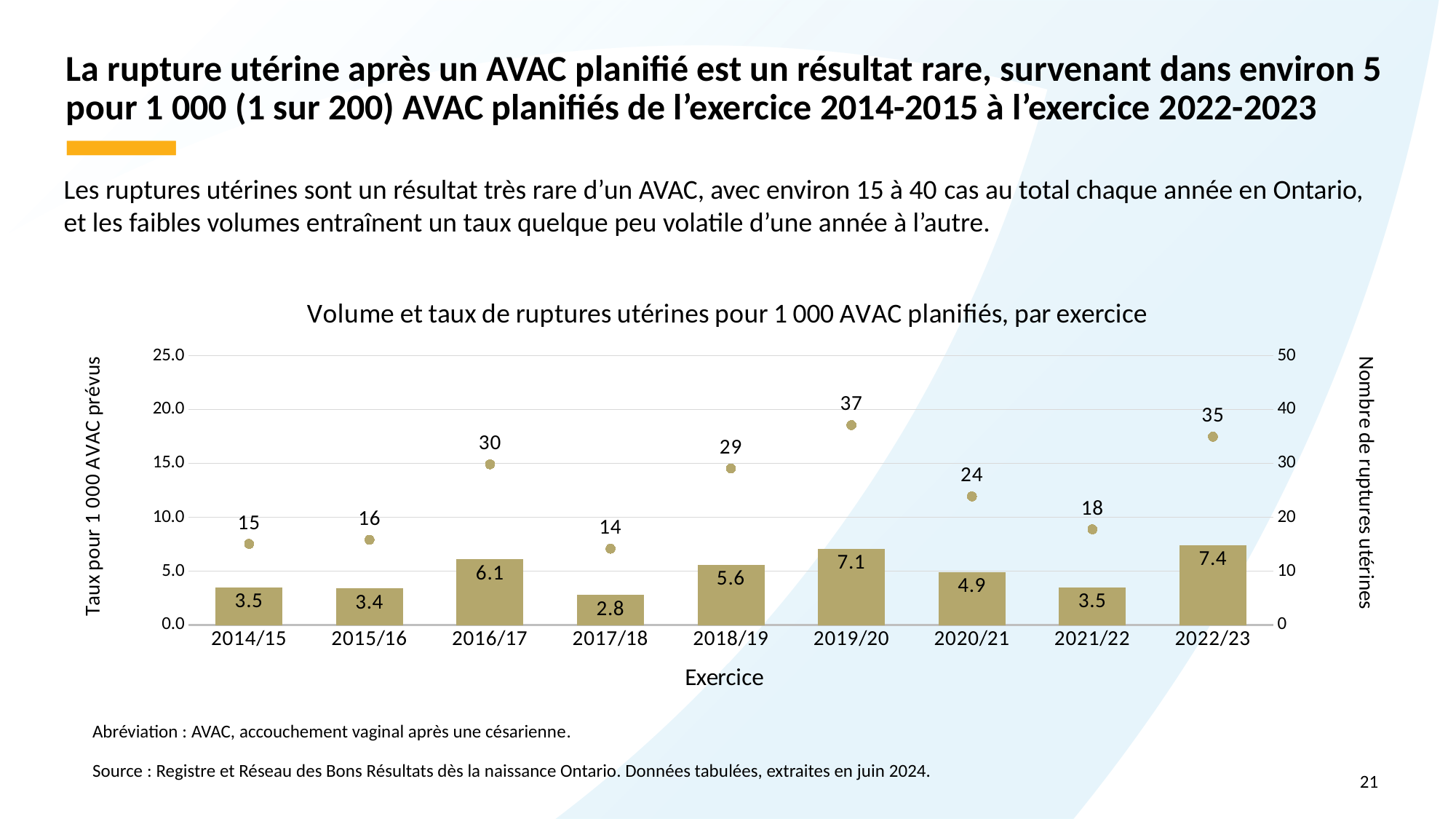
Which fiscal year has the highest rate of uterine ruptures per 1,000 planned VBACs? 2022/23 Which year has a higher number of uterine ruptures, 2016/17 or 2018/19? 2016/17 Which fiscal year has the lowest number of uterine ruptures? 2017/18 What is the title of the chart? Volume et taux de ruptures utérines pour 1 000 AVAC planifiés, par exercice Does the rate per 1,000 planned VBACs rise or fall from 2021/22 to 2022/23? Rise What is the difference in the rate per 1,000 planned VBACs between 2022/23 and 2020/21? 2.5 What kind of chart is used to show the rate per 1,000 planned VBACs? Bar chart What is the rate of uterine ruptures per 1,000 planned VBACs (bar value) for 2016/17? 6.1 What is the number of uterine ruptures (dot value) for 2019/20? 37 How many fiscal years are shown on the x axis of the chart? 9 What is the difference in the number of uterine ruptures between 2019/20 and 2021/22? 19 What is the rate per 1,000 planned VBACs shown for 2017/18? 2.8